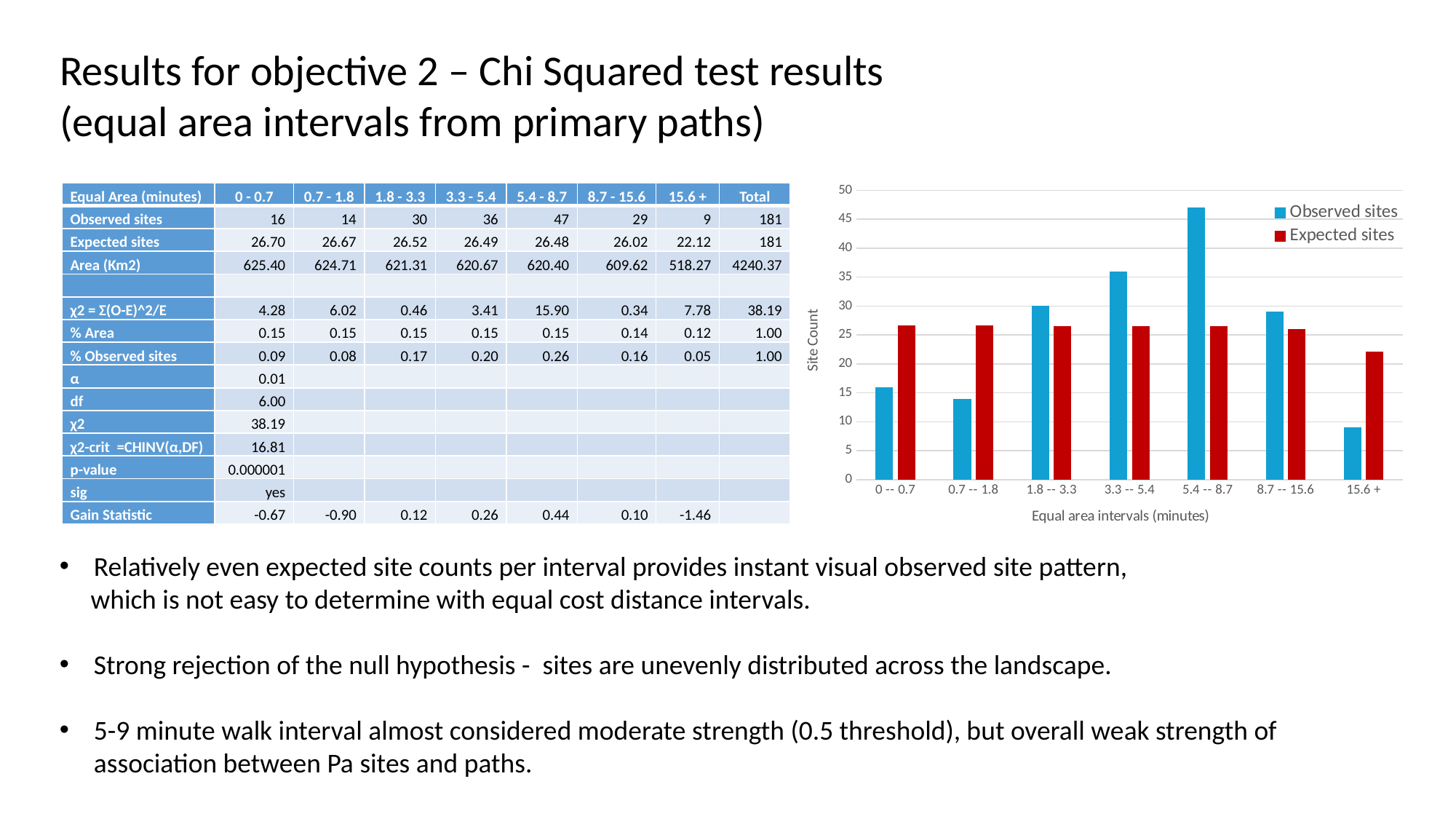
What is the Observed sites value for the 1.8 -- 3.3 interval? 30 Which interval has the lowest Observed sites value in the chart? 15.6 + Is the Expected sites value for the 15.6 + interval greater or less than 25? less For the 0 -- 0.7 interval, which is larger: Observed sites or Expected sites? Expected sites How many equal area intervals are shown on the x axis of the chart? 7 Is the Observed sites value for the 3.3 -- 5.4 interval greater or less than 35? greater What is the title of the chart's vertical axis? Site Count Which interval has the lowest Expected sites value in the chart? 15.6 + Which interval has the highest Observed sites value in the chart? 5.4 -- 8.7 How many series does the chart's legend list? 2 What is the Observed sites value for the 5.4 -- 8.7 interval? 47 What kind of chart is shown on the slide? bar chart